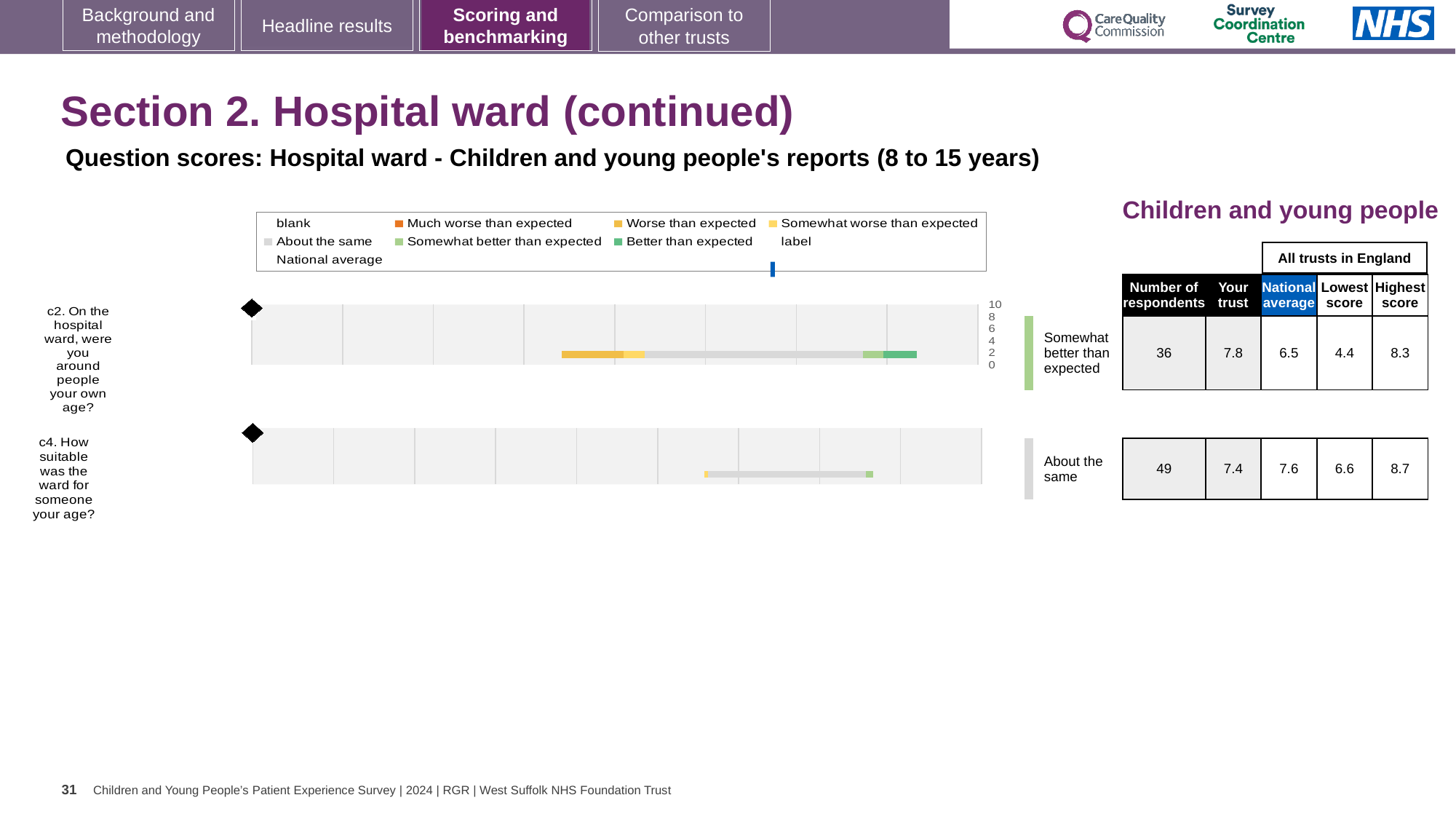
What is the difference between the highest score and the lowest score for c2? 3.9 Which benchmark category is c4 placed in? About the same What is the lowest score among all trusts in England for c4? 6.6 How many respondents answered c2? 36 What is the national average score for c4 (How suitable was the ward for someone your age?)? 7.6 For c2, which is larger: the 'Your trust' score or the national average? Your trust What kind of chart is used to show the question scores for c2 and c4? bar chart What is the 'Your trust' score for c2 (On the hospital ward, were you around people your own age?)? 7.8 Which benchmark category is c2 placed in? Somewhat better than expected Which question has the higher number of respondents, c2 or c4? c4 How many questions are plotted on the slide? 2 For c4, how much higher is the national average than the 'Your trust' score? 0.2